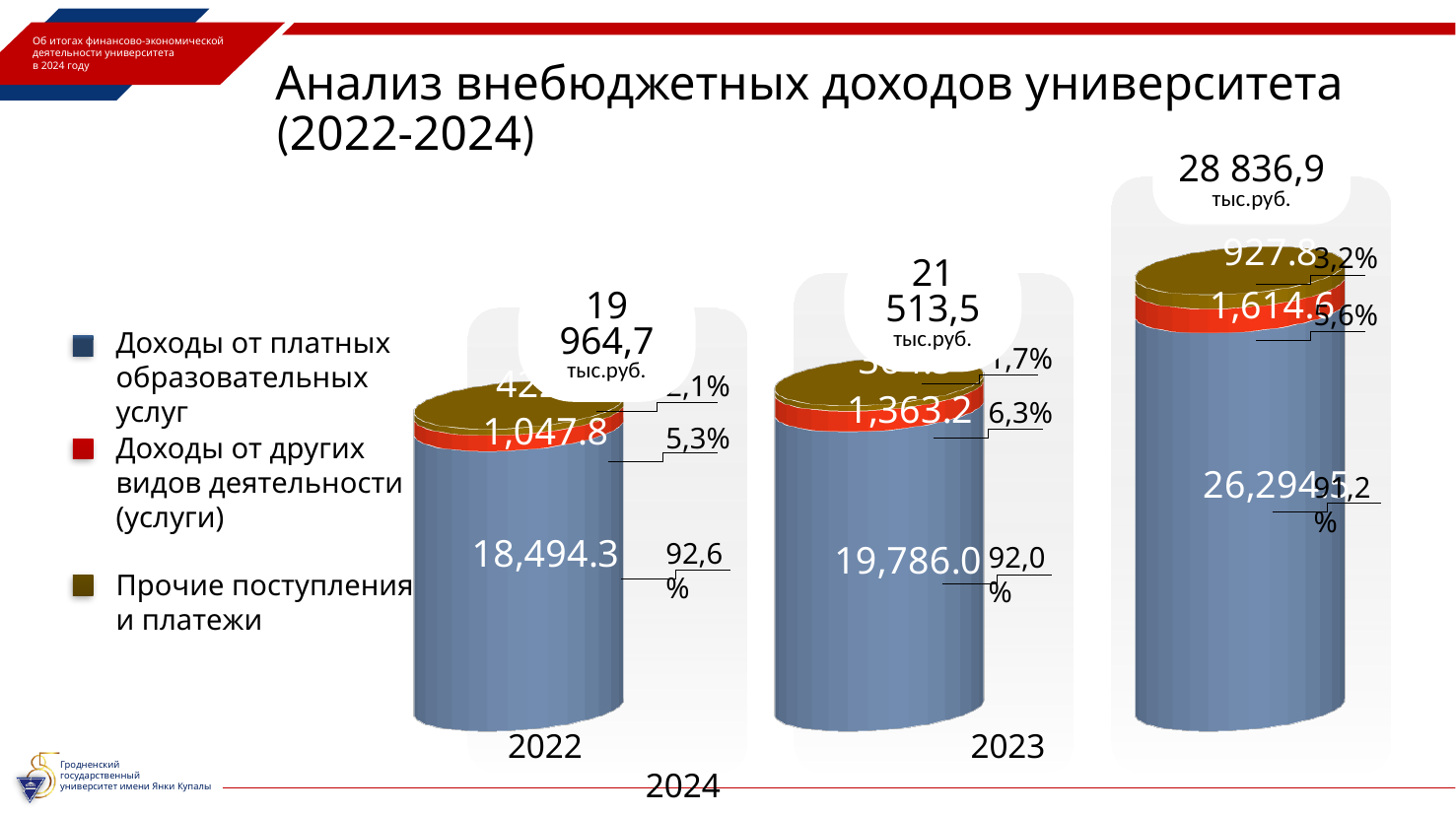
What percentage share does 'Доходы от платных образовательных услуг' have in 2022? 92,6% What is the value of 'Доходы от других видов деятельности (услуги)' for 2024? 1,614.6 How many years (categories) are shown in the chart? 3 What is the value of 'Прочие поступления и платежи' for 2024? 927.8 What is the total shown above the 2023 bar? 21 513,5 тыс.руб. What is the total shown above the 2024 bar? 28 836,9 тыс.руб. Which year has the highest total income? 2024 What is the value of 'Доходы от платных образовательных услуг' for 2023? 19,786.0 What is the value of 'Доходы от других видов деятельности (услуги)' for 2023? 1,363.2 How many series does the legend list? 3 What is the value of 'Доходы от платных образовательных услуг' for 2022? 18,494.3 What kind of chart is shown on the slide? bar chart